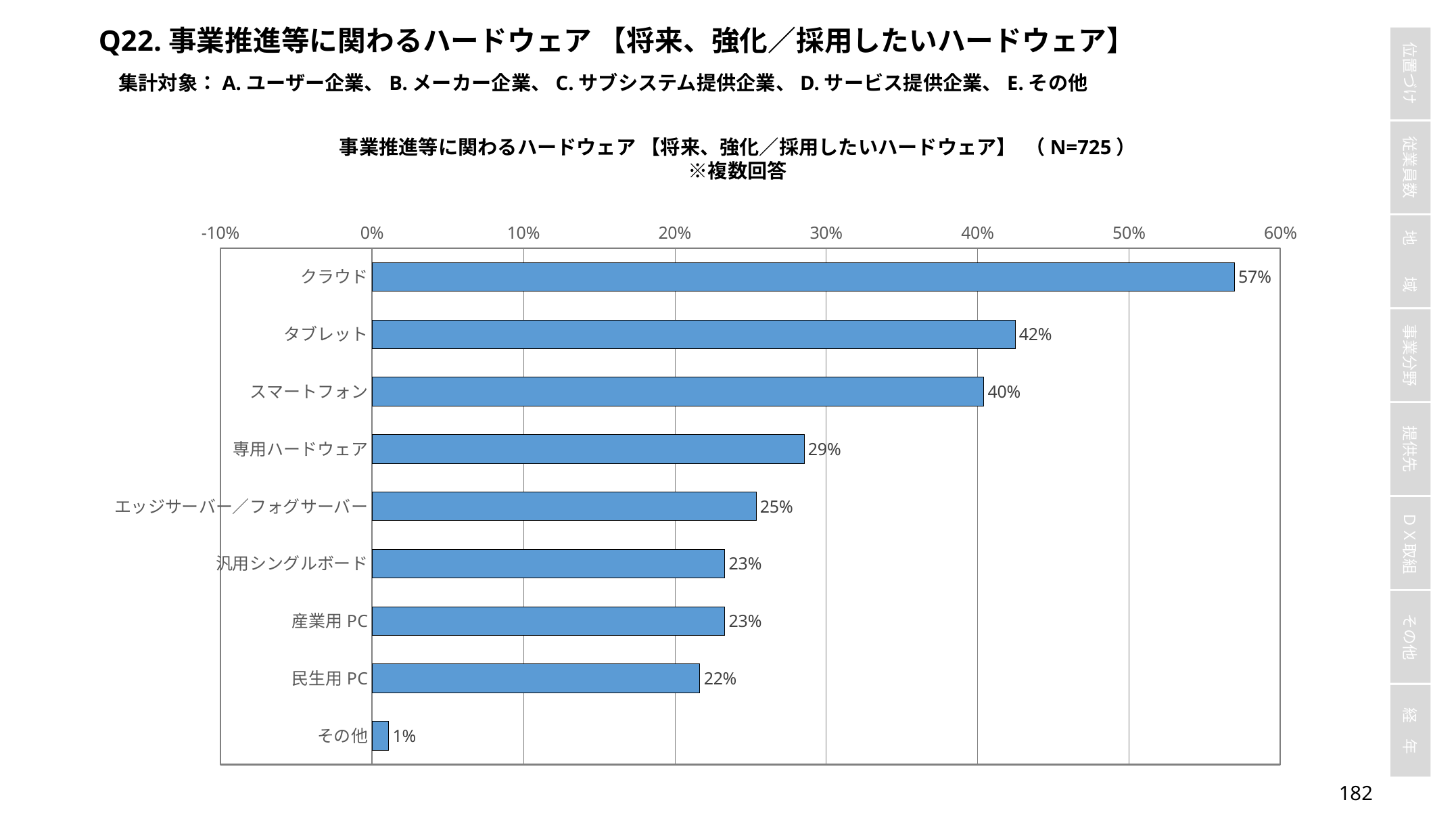
What is the difference between the values for クラウド and タブレット? 15% Which category has the lowest value? その他 What kind of chart is shown on the slide? Bar chart What is the difference between the values for タブレット and スマートフォン? 2% Which category has the highest value? クラウド What is the value for クラウド? 57% What is the value for スマートフォン? 40% What is the value for 民生用 PC? 22% How many categories are shown in the chart? 9 What is the value for エッジサーバー／フォグサーバー? 25% What is the sample size (N) stated in the chart title? 725 Which is larger, the value for 専用ハードウェア or the value for 産業用 PC? 専用ハードウェア